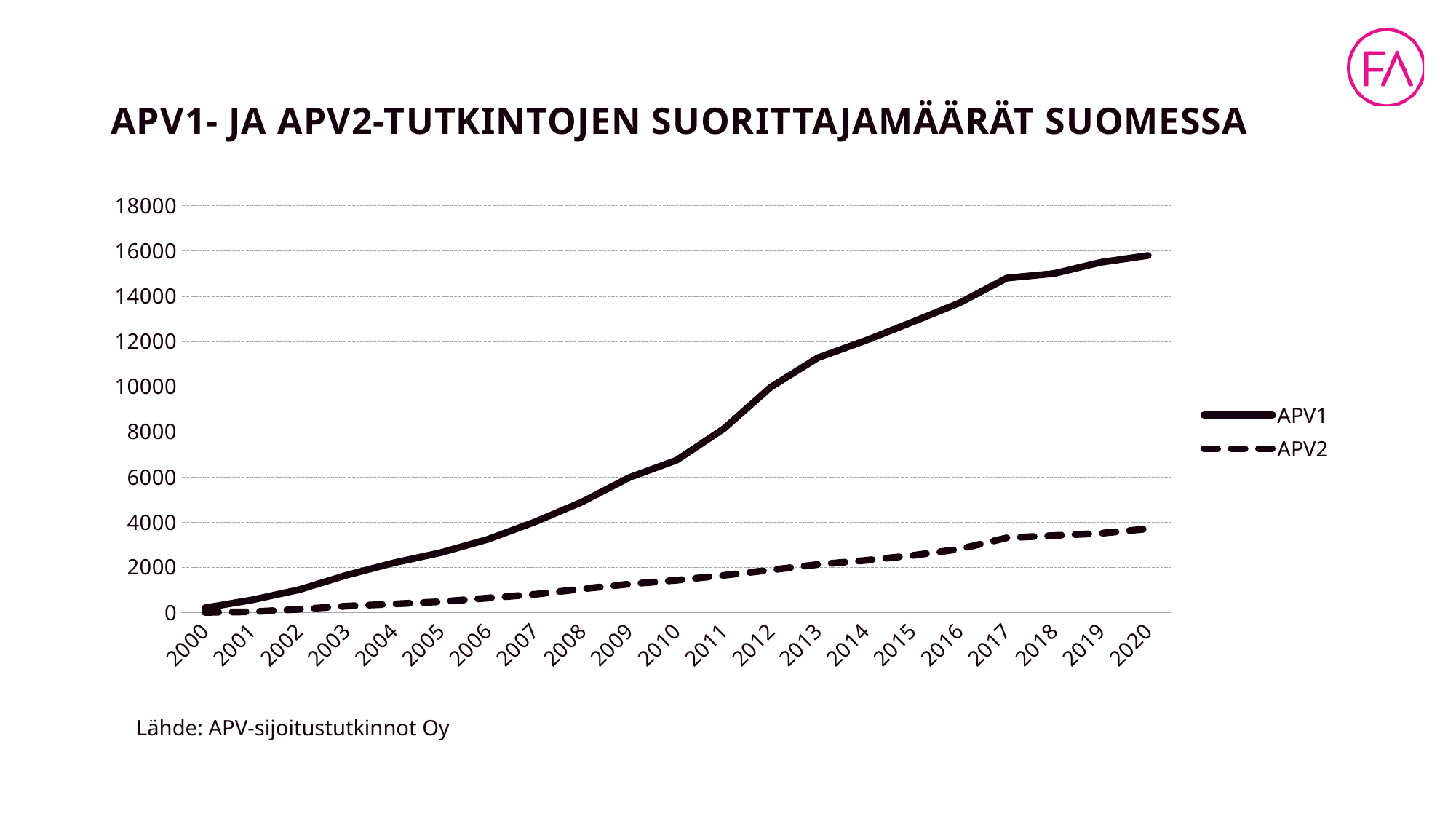
How many years are shown on the x axis? 21 In which year is the APV2 value lowest? 2000 Is the APV1 value for 2020 greater or less than 14000? greater Is the APV1 value for 2013 greater or less than 10000? greater What kind of chart is shown on the slide? line chart Which series is drawn with a dashed line? APV2 Which series has the larger value in 2015, APV1 or APV2? APV1 Does the APV2 line rise or fall from 2000 to 2020? rise In which year is the APV1 value highest? 2020 Does the APV1 line rise or fall from 2000 to 2020? rise Is the APV2 value for 2020 greater or less than 4000? less How many series does the legend list? 2